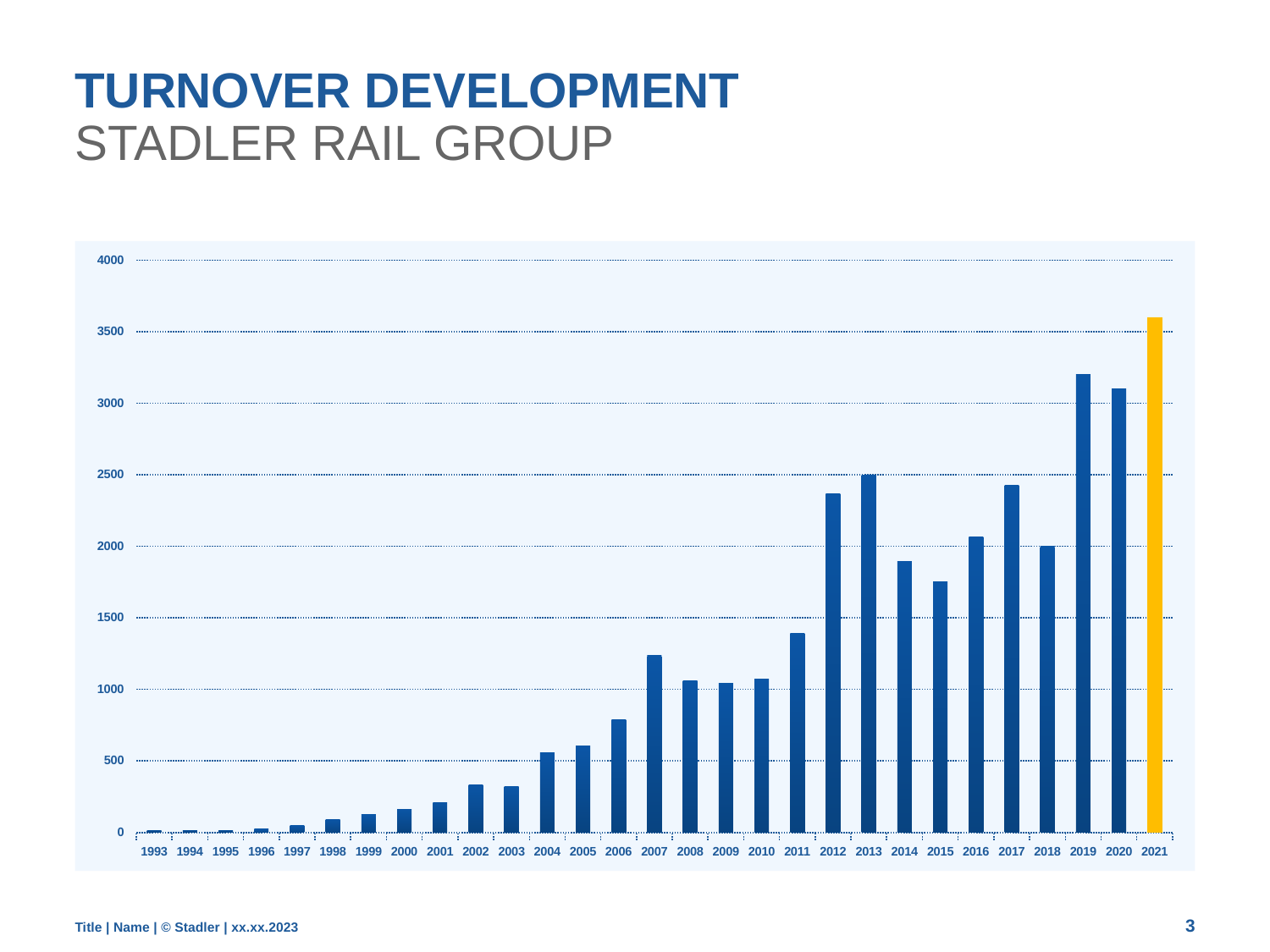
Which bar in the chart is coloured differently (yellow) from the others? 2021 Is the value for 2006 greater or less than 1000? less Is the value for 2012 greater or less than 2000? greater What kind of chart is shown on the slide? bar chart Overall, do the values rise or fall from 1993 to 2021? rise Which year has the larger value, 2016 or 2017? 2017 How many years are shown on the x axis of the chart? 29 Which year has the highest turnover in the chart? 2021 Is the value for 2021 greater or less than 3500? greater